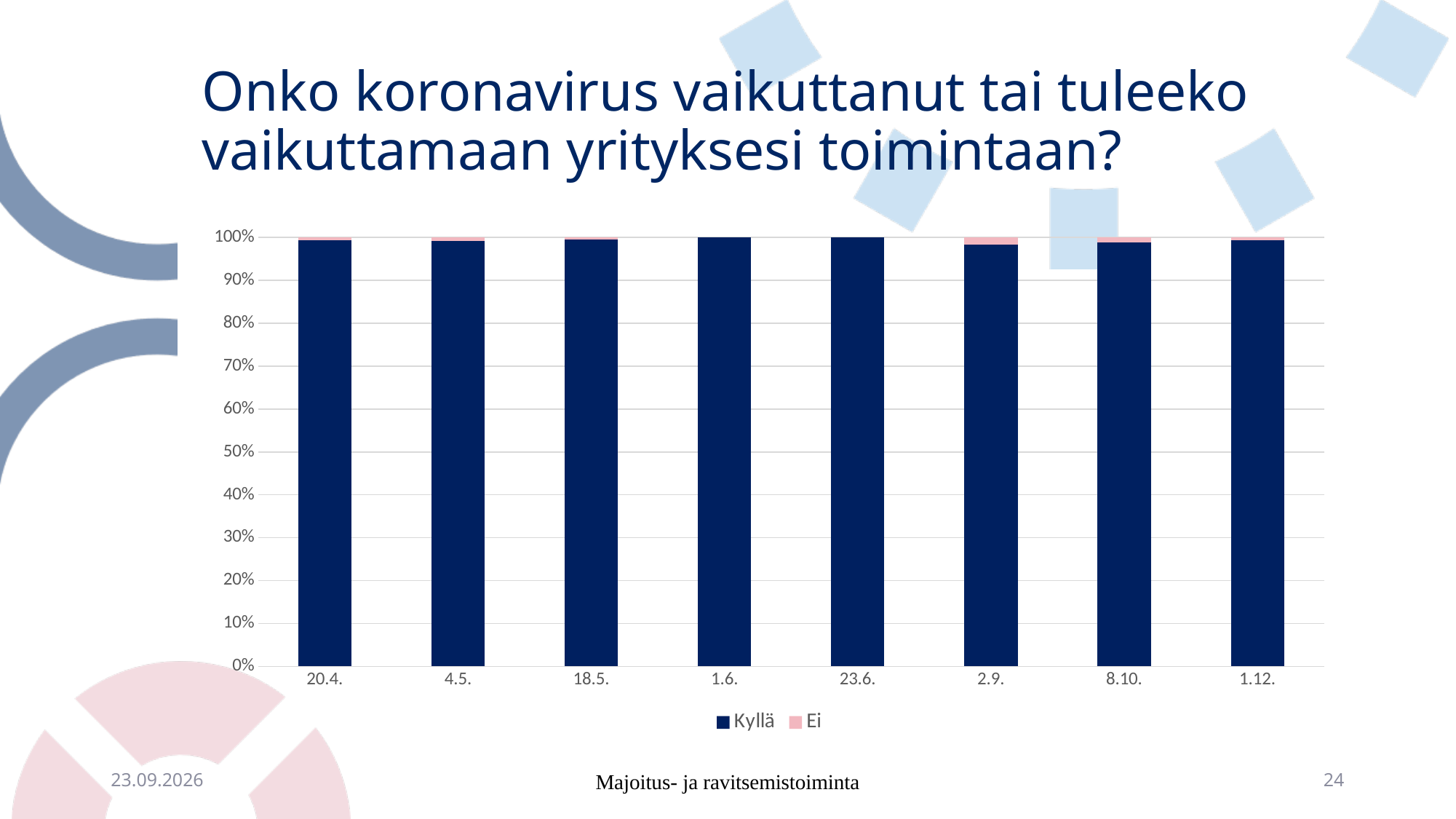
What is the total of the stacked bar for 23.6.? 100% Is the Ei value for 2.9. greater or less than 10%? less Which date has the largest Ei share? 2.9. Which series is shown in dark blue? Kyllä Is the Kyllä value for 20.4. greater or less than 90%? greater What is the first date shown on the x axis? 20.4. Is the Kyllä value for 1.12. greater or less than 50%? greater What kind of chart is shown on the slide? bar chart How many dates are shown along the x axis? 8 What are the two series named in the legend? Kyllä and Ei Which is larger for 4.5., the Kyllä value or the Ei value? Kyllä How many series does the legend list? 2